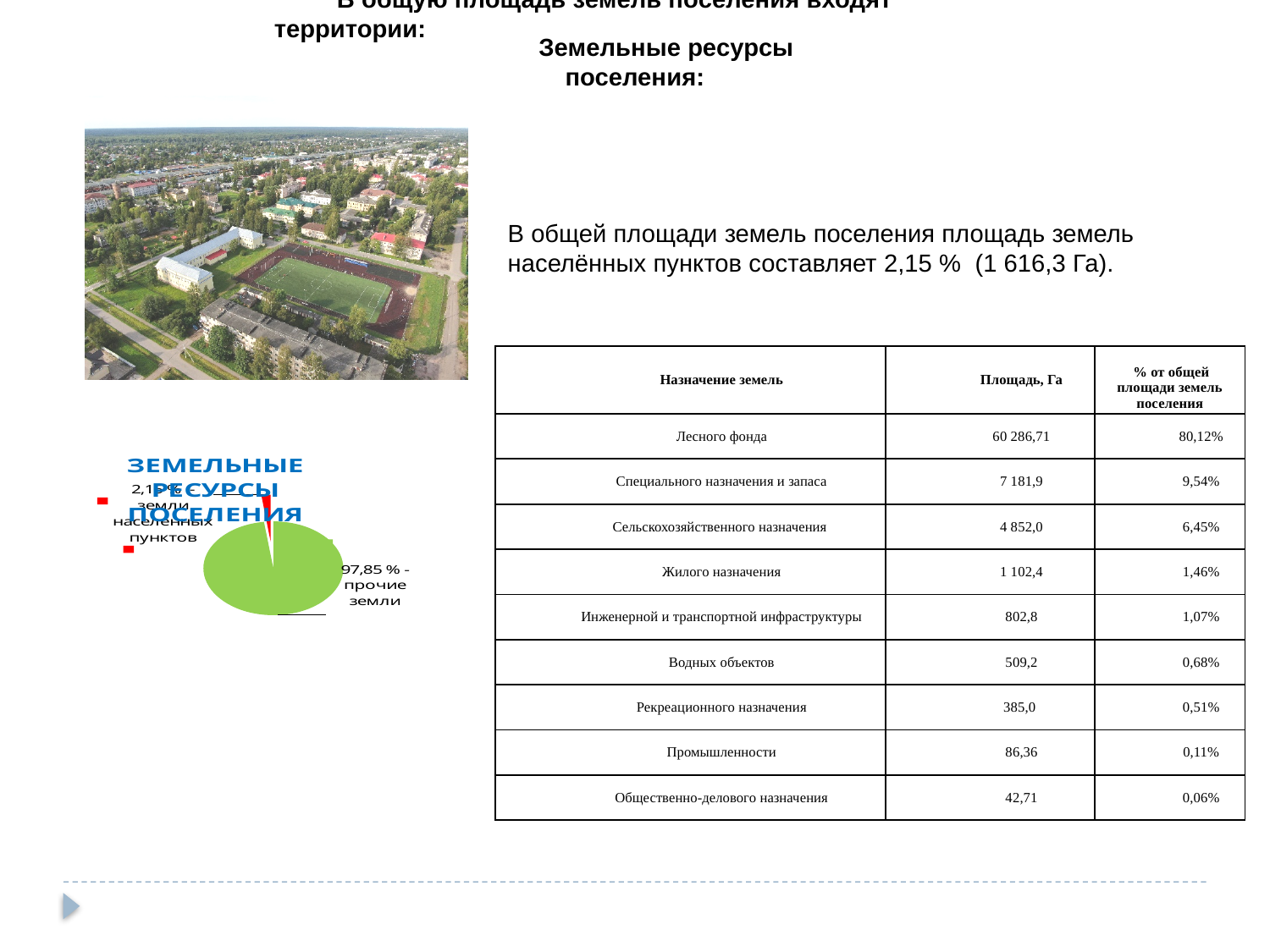
Which slice of the pie chart is the largest? прочие земли How many slices does the pie chart have? 2 What is the difference in percentage points between the two slices of the pie chart? 95,7 In the pie chart, which is larger: the share for прочие земли or the share for земли населённых пунктов? прочие земли In the pie chart, what share is labelled for прочие земли? 97,85 % What colour is the прочие земли slice in the pie chart? green What kind of chart is shown on the left of the slide? pie chart In the pie chart, what share is labelled for земли населённых пунктов? 2,15 % Which slice of the pie chart is the smallest? земли населённых пунктов What is the title of the pie chart? ЗЕМЕЛЬНЫЕ РЕСУРСЫ ПОСЕЛЕНИЯ